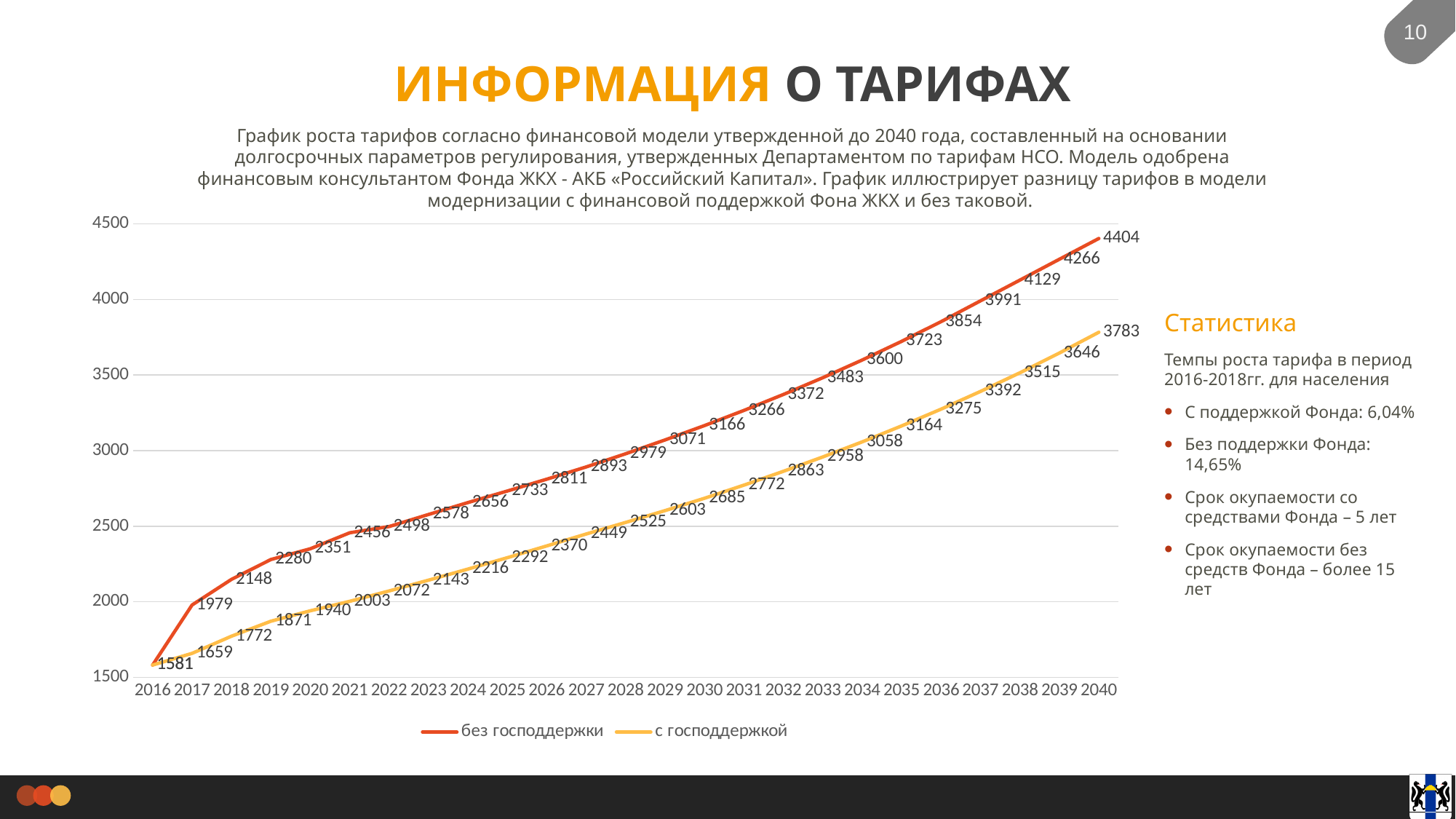
What is the value of the 'без господдержки' series in 2040? 4404 How many years are plotted along the x axis? 25 What is the value of the 'с господдержкой' series in 2040? 3783 Do the values of the 'без господдержки' series rise or fall from 2016 to 2040? rise What kind of chart is shown on the slide? line chart What is the difference between the 'без господдержки' and 'с господдержкой' values in 2040? 621 Which series has the higher value in 2025, 'без господдержки' or 'с господдержкой'? без господдержки How many series does the legend list? 2 What are the two legend entries of the chart? без господдержки, с господдержкой What is the value of the 'с господдержкой' series in 2030? 2685 In which year does the 'с господдержкой' series reach its highest value? 2040 What is the value of the 'без господдержки' series in 2030? 3166